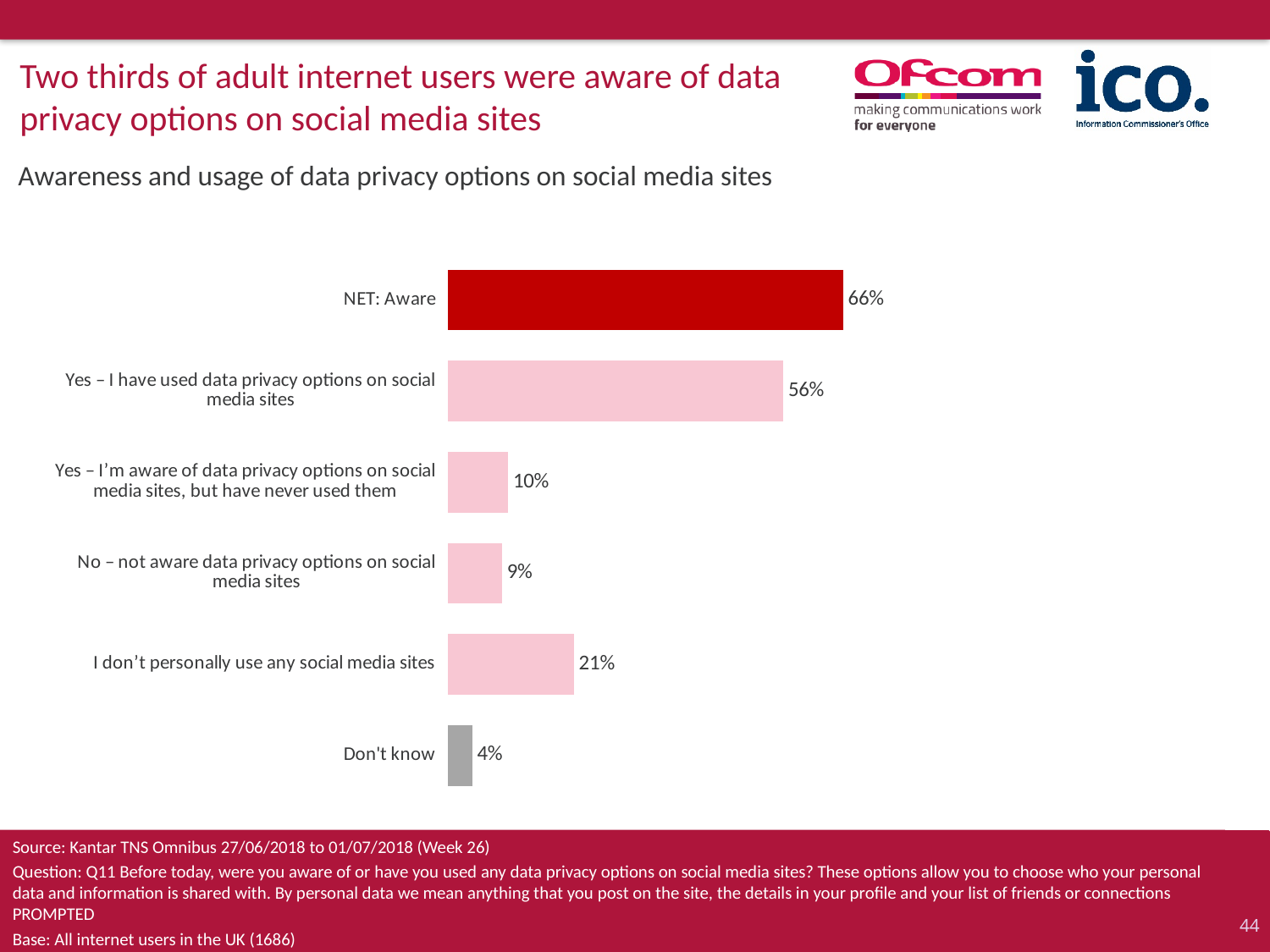
Which category has the lowest value? Don't know Which category has the highest value? NET: Aware What is the subtitle of the chart? Awareness and usage of data privacy options on social media sites What is the value for 'I don't personally use any social media sites'? 21% What is the value for 'Don't know'? 4% What is the difference between NET: Aware and 'I don't personally use any social media sites'? 45 percentage points What is the difference between 'Yes – I have used data privacy options on social media sites' and 'Yes – I'm aware of data privacy options on social media sites, but have never used them'? 46 percentage points What percentage of respondents said they have used data privacy options on social media sites? 56% Which is larger: 'No – not aware data privacy options on social media sites' or 'I don't personally use any social media sites'? I don't personally use any social media sites What kind of chart is shown on the slide? Bar chart What is the value for NET: Aware? 66% How many categories are shown in the chart? 6